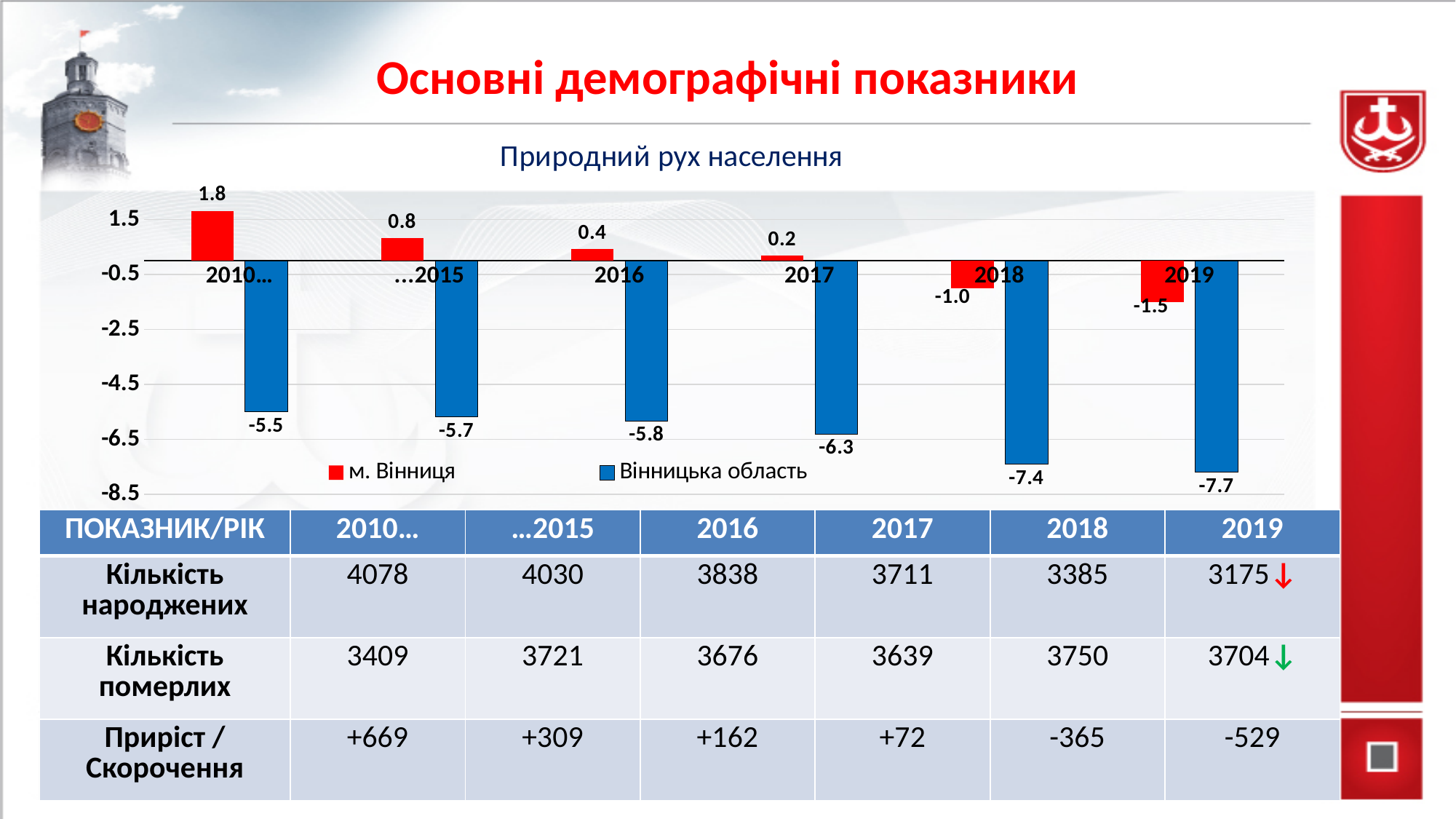
What is the value for Вінницька область in 2017 on the chart? -6.3 What is the value for м. Вінниця in 2018 on the chart? -1.0 How many series does the chart legend list? 2 What kind of chart is shown on the slide? Bar chart Do the values for м. Вінниця rise or fall from 2010… to 2019? Fall What is the value for Вінницька область in 2019 on the chart? -7.7 In which year is the value for Вінницька область the lowest? 2019 In which year is the value for м. Вінниця the highest? 2010… Which is larger in 2016: the value for м. Вінниця or for Вінницька область? м. Вінниця What is the difference between the м. Вінниця value in 2010… and in 2019? 3.3 How many years are shown on the x axis of the chart? 6 What is the value for м. Вінниця in 2010… on the chart? 1.8